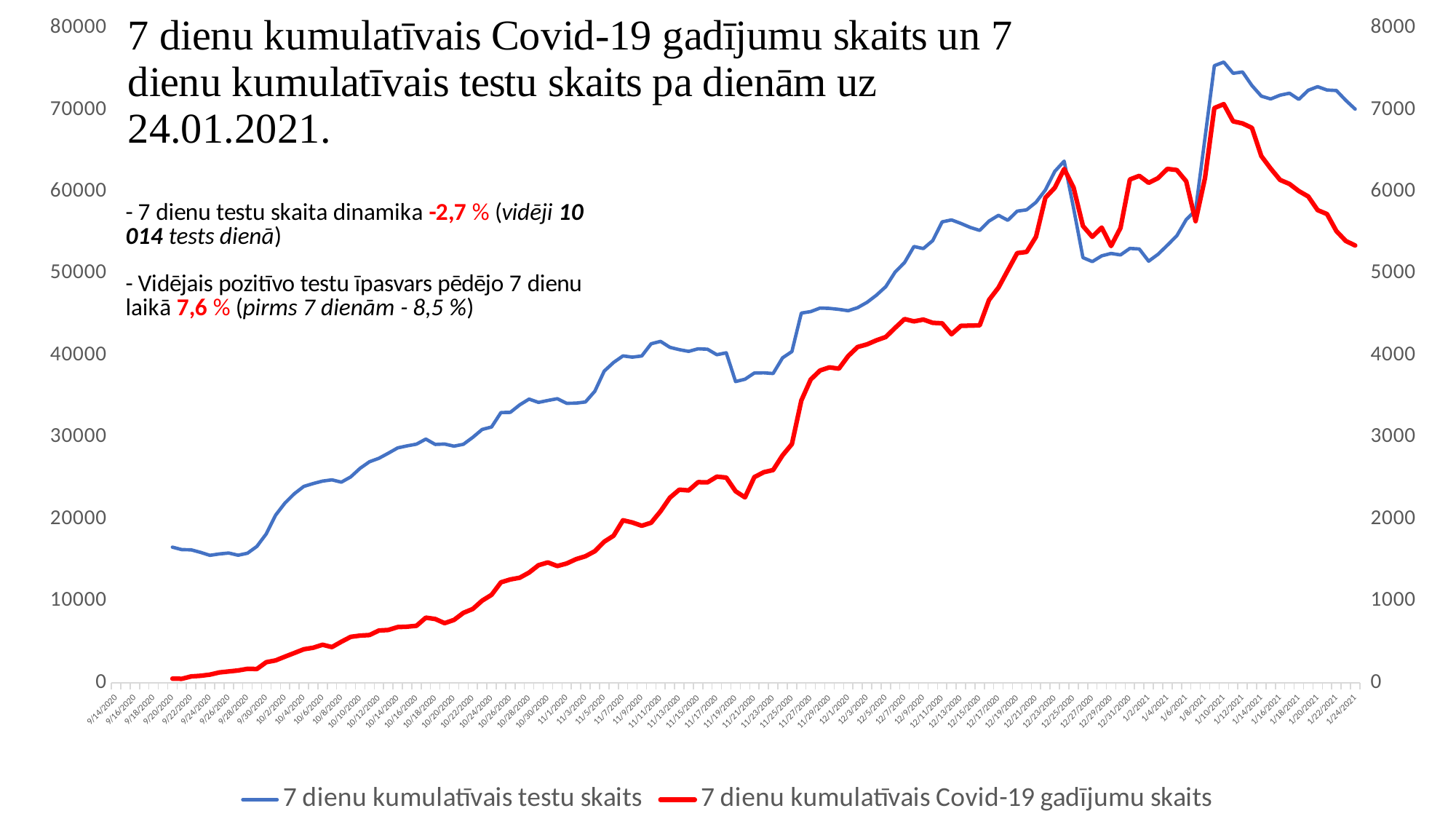
What kind of chart is shown on the slide? line chart Is the value of the '7 dienu kumulatīvais Covid-19 gadījumu skaits' line at 1/24/2021 greater or less than 6000 on the right axis? less What is the highest value shown on the left vertical axis? 80000 Does the '7 dienu kumulatīvais Covid-19 gadījumu skaits' line rise or fall between 1/10/2021 and 1/24/2021? fall Which series is drawn in red? 7 dienu kumulatīvais Covid-19 gadījumu skaits Is the value of the '7 dienu kumulatīvais testu skaits' line at its first plotted point (around 9/20/2020) greater or less than 20000 on the left axis? less Does the '7 dienu kumulatīvais testu skaits' line rise or fall between 9/28/2020 and 12/23/2020? rise Is the peak of the '7 dienu kumulatīvais Covid-19 gadījumu skaits' line (around 1/10/2021) greater or less than 6000 on the right axis? greater How many series does the legend list? 2 Around which date does the '7 dienu kumulatīvais testu skaits' line reach its highest point? 1/10/2021